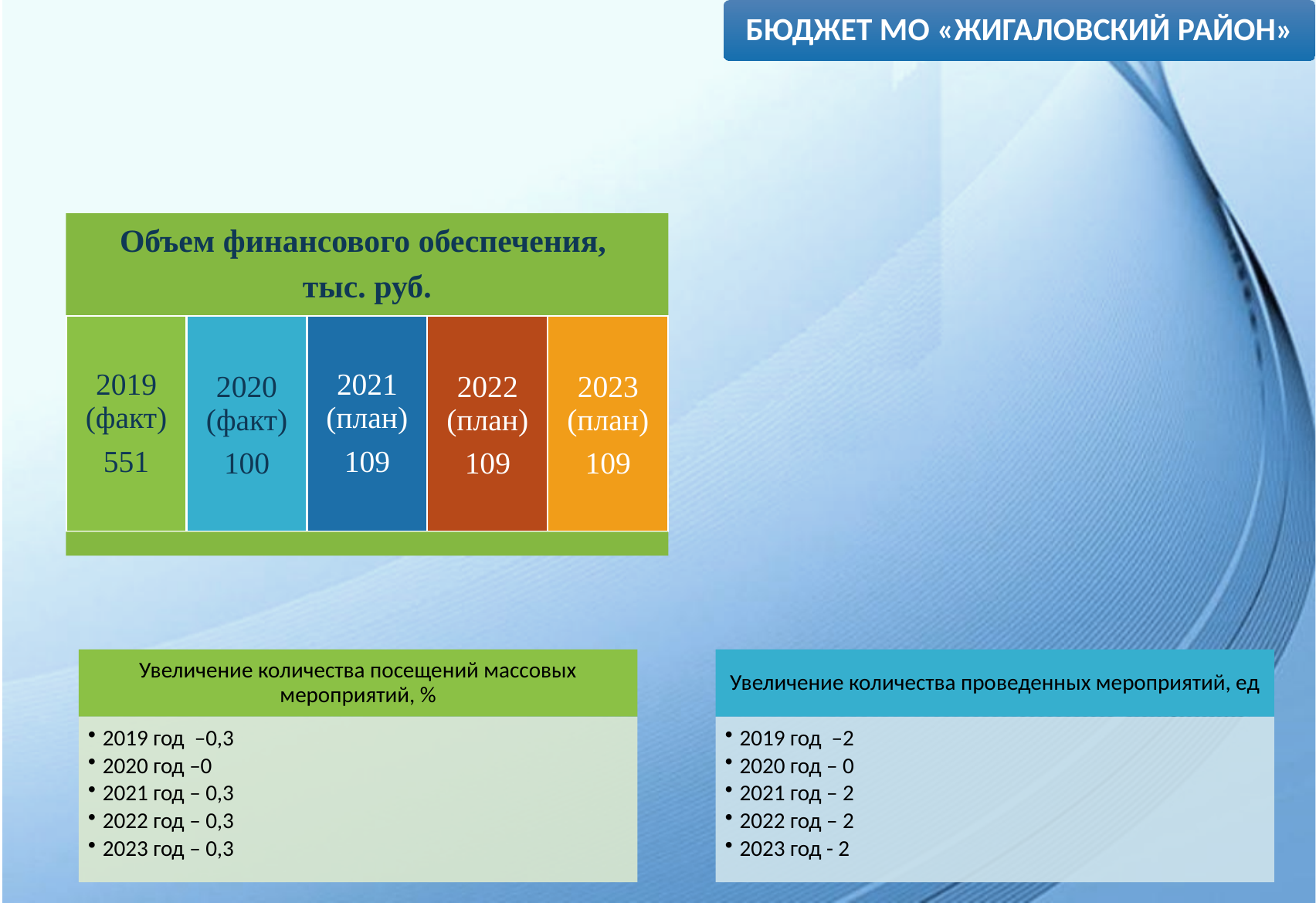
In the 'Объем финансового обеспечения, тыс. руб.' graphic, what is the value for 2020 (факт)? 100 In the 'Объем финансового обеспечения, тыс. руб.' graphic, does the value rise or fall from 2019 to 2020? fall In the 'Объем финансового обеспечения, тыс. руб.' graphic, which is larger: the value for 2019 or the value for 2023? 2019 How many years are shown in the 'Объем финансового обеспечения, тыс. руб.' graphic? 5 In the 'Объем финансового обеспечения, тыс. руб.' graphic, what colour is the block for 2022 (план)? Dark orange (brown-red) In the 'Объем финансового обеспечения, тыс. руб.' graphic, what is the difference between the 2019 value and the 2020 value? 451 In the 'Объем финансового обеспечения, тыс. руб.' graphic, what is the planned value for 2022? 109 In the 'Объем финансового обеспечения, тыс. руб.' graphic, what is the value for 2019 (факт)? 551 What unit is given in the title of the financial graphic on the left of the slide? тыс. руб. In the 'Объем финансового обеспечения, тыс. руб.' graphic, which year has the lowest value? 2020 (факт) In the 'Объем финансового обеспечения, тыс. руб.' graphic, what is the difference between the 2021 plan value and the 2020 fact value? 9 In the 'Объем финансового обеспечения, тыс. руб.' graphic, which year has the highest value? 2019 (факт)